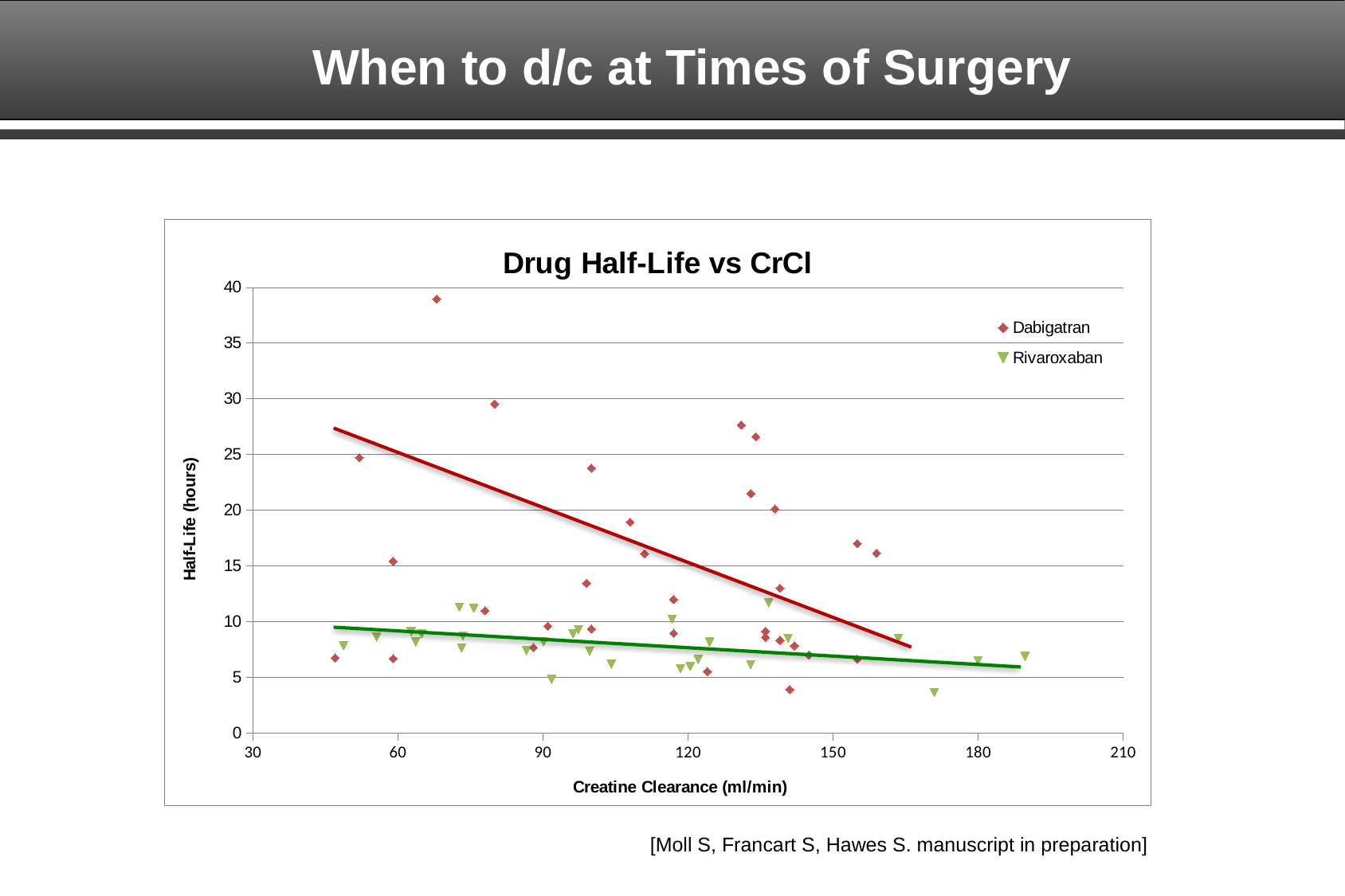
How many series does the legend list? 2 Which series contains the point with the highest half-life on the chart? Dabigatran What is the title of the chart? Drug Half-Life vs CrCl Does the Rivaroxaban trend line rise or fall as creatine clearance increases? fall Is the highest Rivaroxaban half-life value greater or less than 15 hours? less Which series has the steeper trend line, Dabigatran or Rivaroxaban? Dabigatran Does the Dabigatran trend line rise or fall as creatine clearance increases? fall At a creatine clearance of 60 ml/min, which series' trend line shows the higher half-life? Dabigatran Which two series are listed in the chart legend? Dabigatran and Rivaroxaban Is the highest Dabigatran half-life value greater or less than 35 hours? greater What kind of chart is shown on the slide? scatter chart Is the Dabigatran trend line value at a creatine clearance of 165 ml/min greater or less than 10 hours? less